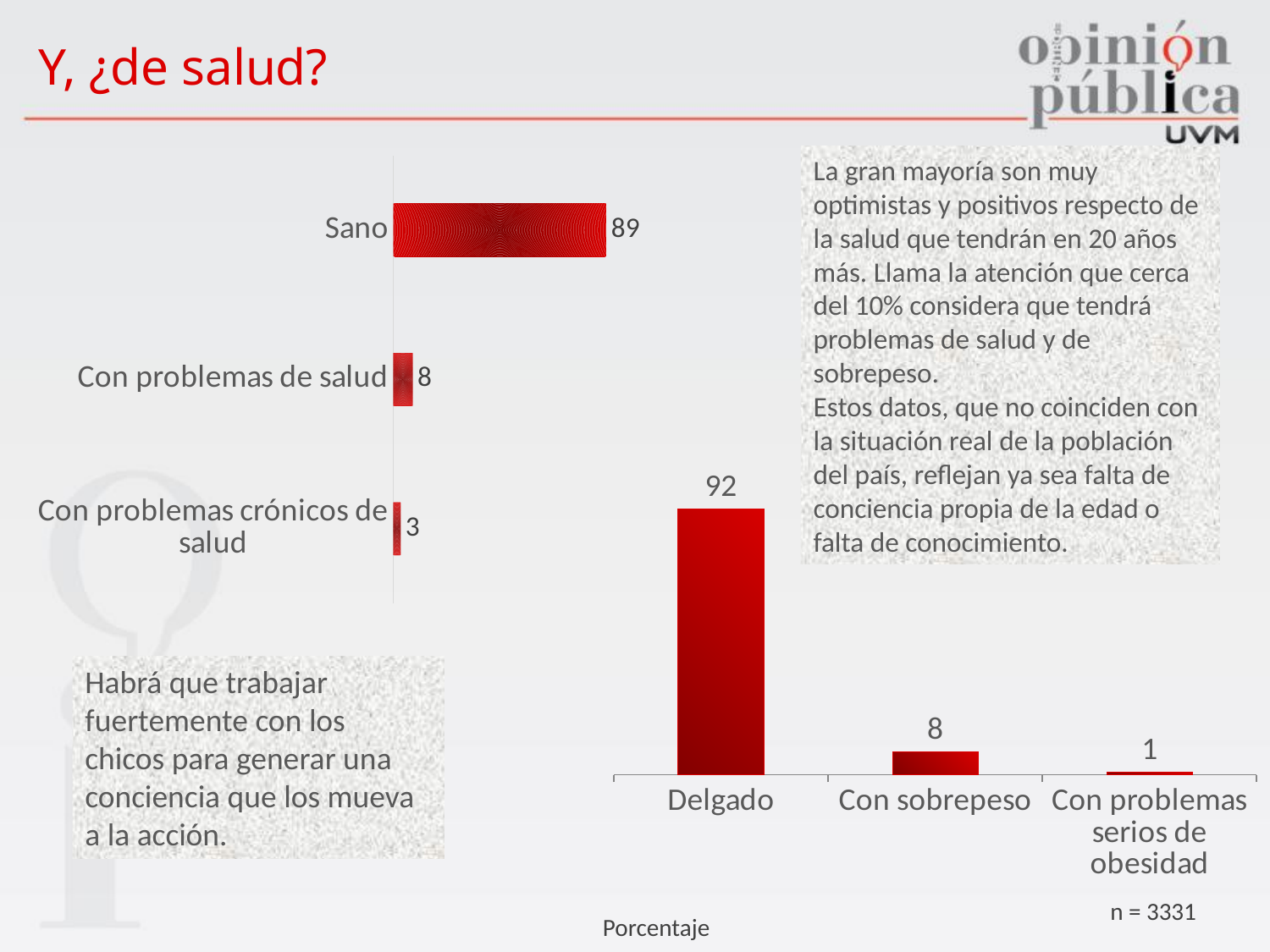
In the horizontal bar chart on the left of the slide, what is the value for "Sano"? 89 In the horizontal bar chart on the left of the slide, what is the value for "Con problemas crónicos de salud"? 3 In the horizontal bar chart on the left of the slide, which category has the lowest value? Con problemas crónicos de salud In the vertical bar chart on the right of the slide, which is larger: the value for "Con sobrepeso" or the value for "Con problemas serios de obesidad"? Con sobrepeso In the vertical bar chart on the right of the slide, what is the difference between the values for "Delgado" and "Con sobrepeso"? 84 In the horizontal bar chart on the left of the slide, how many categories are shown? 3 In the vertical bar chart on the right of the slide, what is the value for "Delgado"? 92 In the vertical bar chart on the right of the slide, do the values rise or fall from left to right along the x axis? fall In the vertical bar chart on the right of the slide, what is the value for "Con problemas serios de obesidad"? 1 In the vertical bar chart on the right of the slide, which category has the highest value? Delgado What type of chart is the chart on the right of the slide? bar chart In the horizontal bar chart on the left of the slide, what is the difference between the values for "Sano" and "Con problemas de salud"? 81